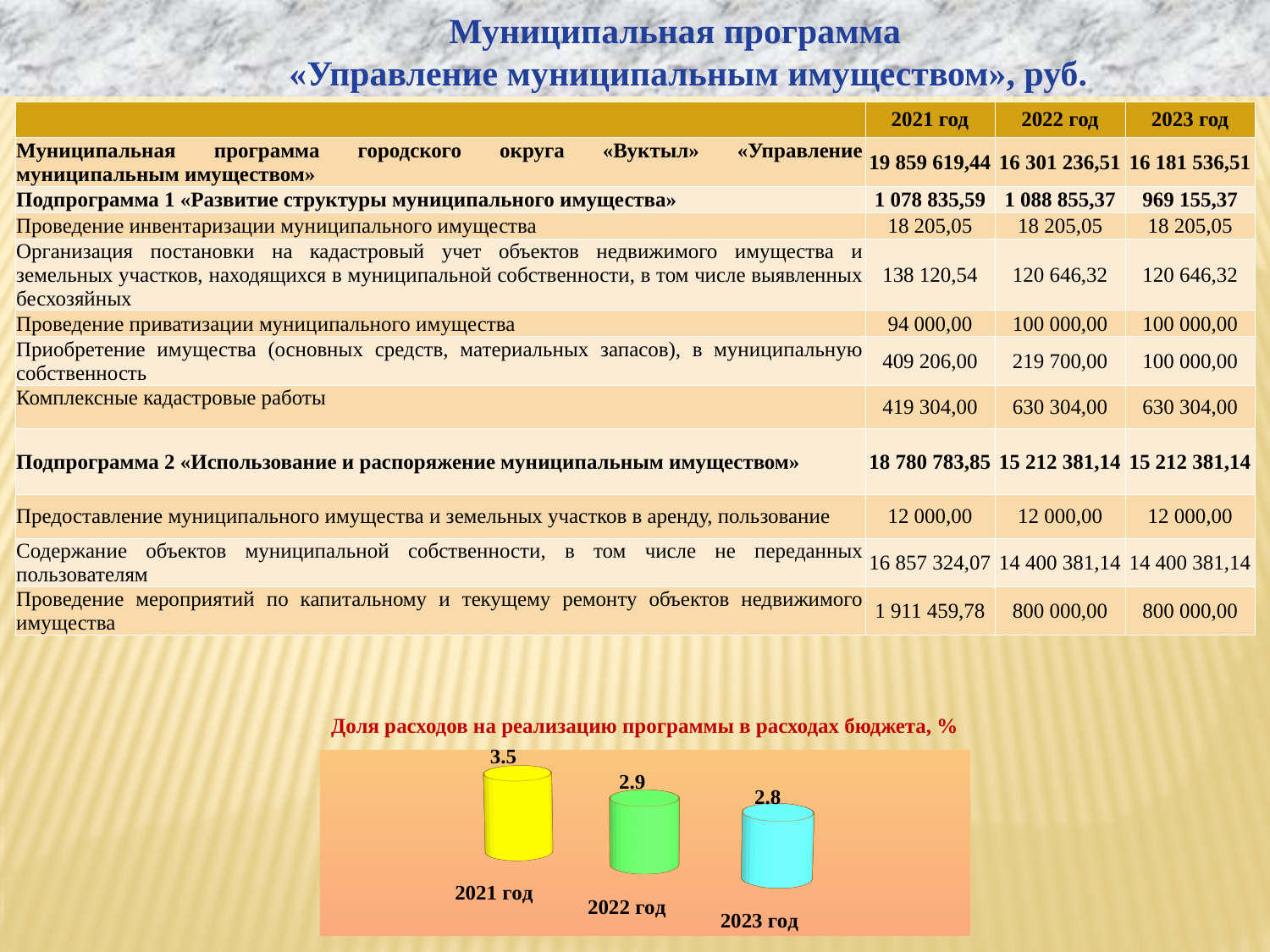
Какого типа диаграмма показана на слайде? Столбчатая (bar chart) В каком году доля расходов на реализацию программы в расходах бюджета была наибольшей? 2021 год Какое значение показано на диаграмме для 2023 года? 2.8 В каком году доля расходов на реализацию программы в расходах бюджета была наименьшей? 2023 год Какое значение показано на диаграмме для 2022 года? 2.9 Как изменяется доля расходов на реализацию программы с 2021 по 2023 год — растёт или снижается? Снижается Каким цветом показан столбец для 2021 года на диаграмме? Жёлтым Что больше: доля расходов в 2022 году или в 2023 году? 2022 год Какое значение показано на диаграмме «Доля расходов на реализацию программы в расходах бюджета, %» для 2021 года? 3.5 Сколько категорий (лет) показано на диаграмме? 3 На сколько доля расходов в 2021 году больше, чем в 2022 году? 0.6 На сколько процентных пунктов доля расходов в 2021 году больше, чем в 2023 году? 0.7